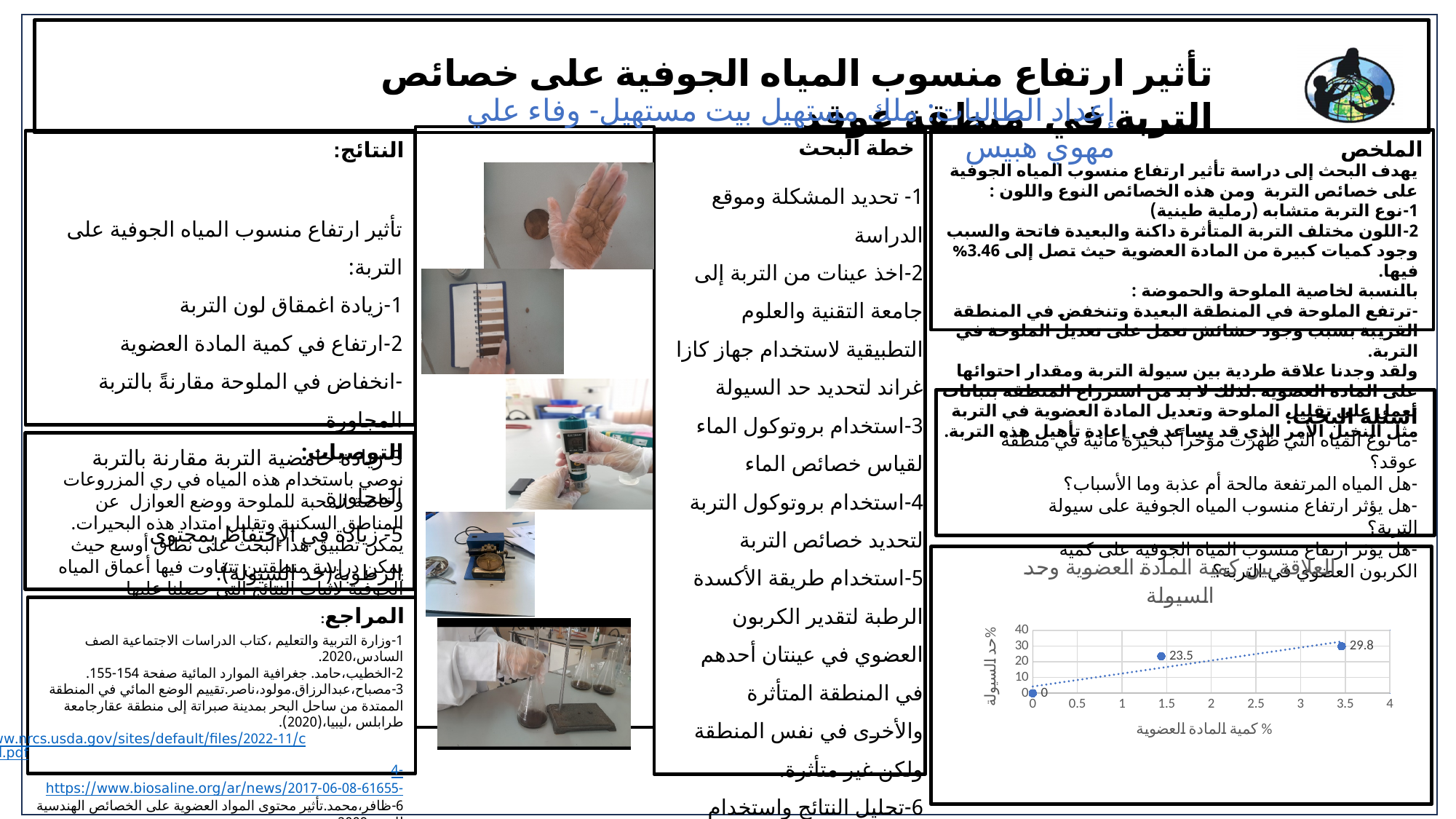
What is the x-axis title of the bottom-right chart? كمية المادة العضوية % In the bottom-right chart, what is the data label of the point with the highest organic matter percentage (around 3.5 on the x axis)? 29.8 In the bottom-right chart, what is the data label of the middle point (around 1.5 on the x axis)? 23.5 In the bottom-right chart, what is the difference between the data labels 29.8 and 23.5? 6.3 In the bottom-right chart, what is the highest data label value shown? 29.8 What is the maximum value shown on the y axis of the bottom-right chart? 40 In the bottom-right chart, which is larger: the value of the point near x = 1.5 or the point near x = 3.5? the point near x = 3.5 What type of chart is shown at the bottom right of the slide? scatter chart How many data points are plotted in the chart at the bottom right? 3 In the bottom-right chart, do the values rise or fall as the organic matter percentage increases along the x axis? rise In the bottom-right chart, what is the lowest data label value shown? 0 In the bottom-right chart, is the value of the point near x = 1.5 greater or less than 20? greater